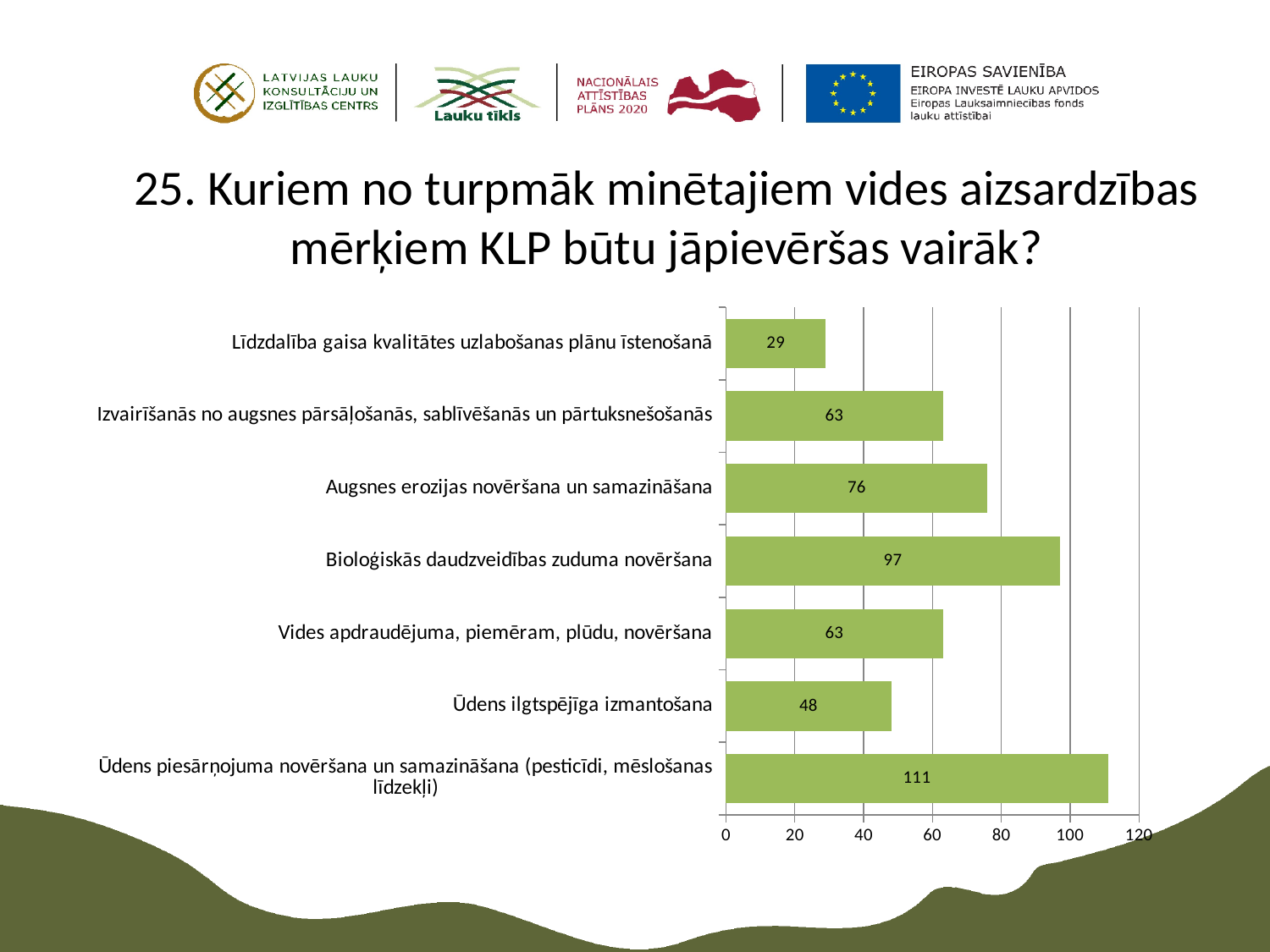
What kind of chart is shown on the slide? bar chart What is the difference between the values for "Augsnes erozijas novēršana un samazināšana" and "Ūdens ilgtspējīga izmantošana"? 28 Which is larger: the value for "Augsnes erozijas novēršana un samazināšana" or the value for "Vides apdraudējuma, piemēram, plūdu, novēršana"? Augsnes erozijas novēršana un samazināšana How many categories are shown in the chart? 7 Which two categories share the same value of 63? Izvairīšanās no augsnes pārsāļošanās, sablīvēšanās un pārtuksnešošanās; Vides apdraudējuma, piemēram, plūdu, novēršana Which category has the highest value? Ūdens piesārņojuma novēršana un samazināšana (pesticīdi, mēslošanas līdzekļi) Which category has the lowest value? Līdzdalība gaisa kvalitātes uzlabošanas plānu īstenošanā What is the difference between the values for "Ūdens piesārņojuma novēršana un samazināšana (pesticīdi, mēslošanas līdzekļi)" and "Bioloģiskās daudzveidības zuduma novēršana"? 14 What is the value for "Līdzdalība gaisa kvalitātes uzlabošanas plānu īstenošanā"? 29 Is the value for "Bioloģiskās daudzveidības zuduma novēršana" greater or less than 80? greater What is the value for "Bioloģiskās daudzveidības zuduma novēršana"? 97 What is the value for "Ūdens ilgtspējīga izmantošana"? 48